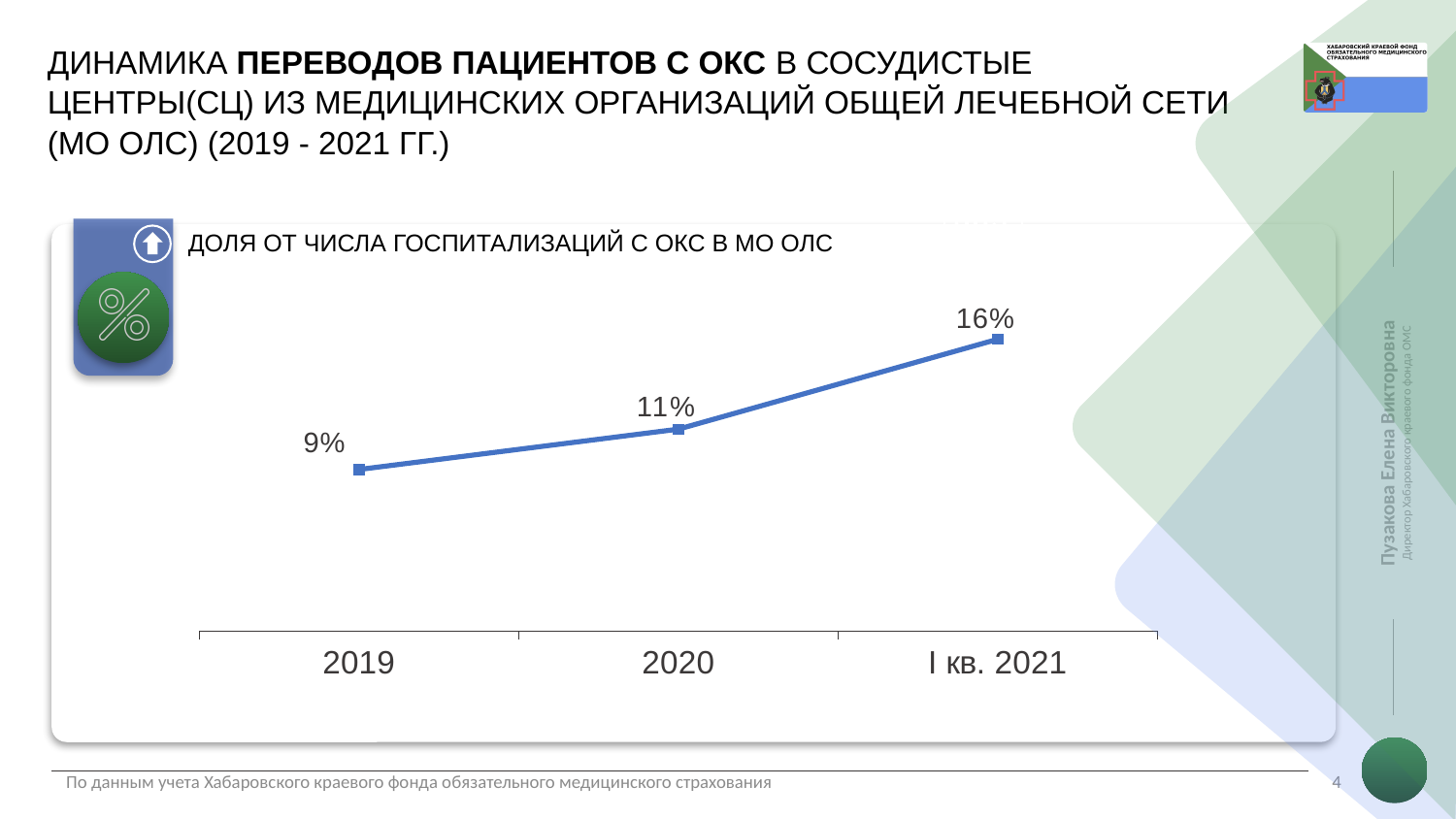
What is the value for 2020? 11% What is the difference between the values for 2020 and 2019? 2% Which period has the highest value? I кв. 2021 What is the difference between the values for I кв. 2021 and 2019? 7% What kind of chart is shown on the slide? Line chart What is the value for 2019? 9% Which period has the lowest value? 2019 What is the title shown above the chart? ДОЛЯ ОТ ЧИСЛА ГОСПИТАЛИЗАЦИЙ С ОКС В МО ОЛС Which is larger, the value for 2020 or the value for I кв. 2021? I кв. 2021 Do the values rise or fall from 2019 to I кв. 2021? Rise How many data points are plotted on the chart? 3 What is the value for I кв. 2021? 16%